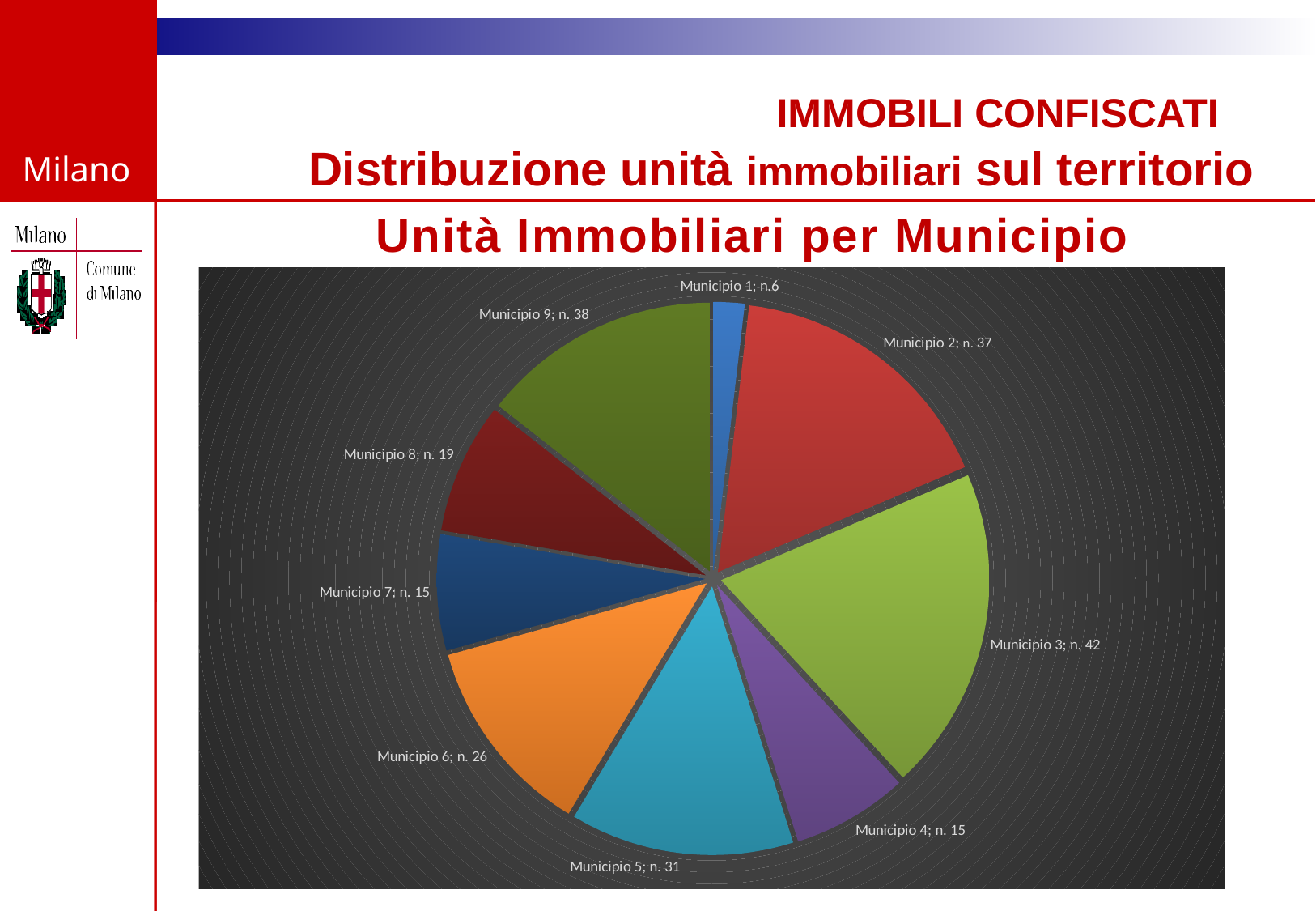
What is the value shown for Municipio 5? 31 Which has a larger value, Municipio 2 or Municipio 9? Municipio 9 What is the value shown for Municipio 7? 15 What is the total number of unità immobiliari across all nine Municipi? 229 What is the difference between the values for Municipio 6 and Municipio 4? 11 Which Municipio has the largest number of unità immobiliari? Municipio 3 How many Municipi (slices) are shown in the pie chart? 9 What kind of chart is shown on the slide? Pie chart Which Municipio has the smallest number of unità immobiliari? Municipio 1 What is the value shown for Municipio 8? 19 How many unità immobiliari does the chart show for Municipio 2? 37 What is the difference between the values for Municipio 3 and Municipio 9? 4